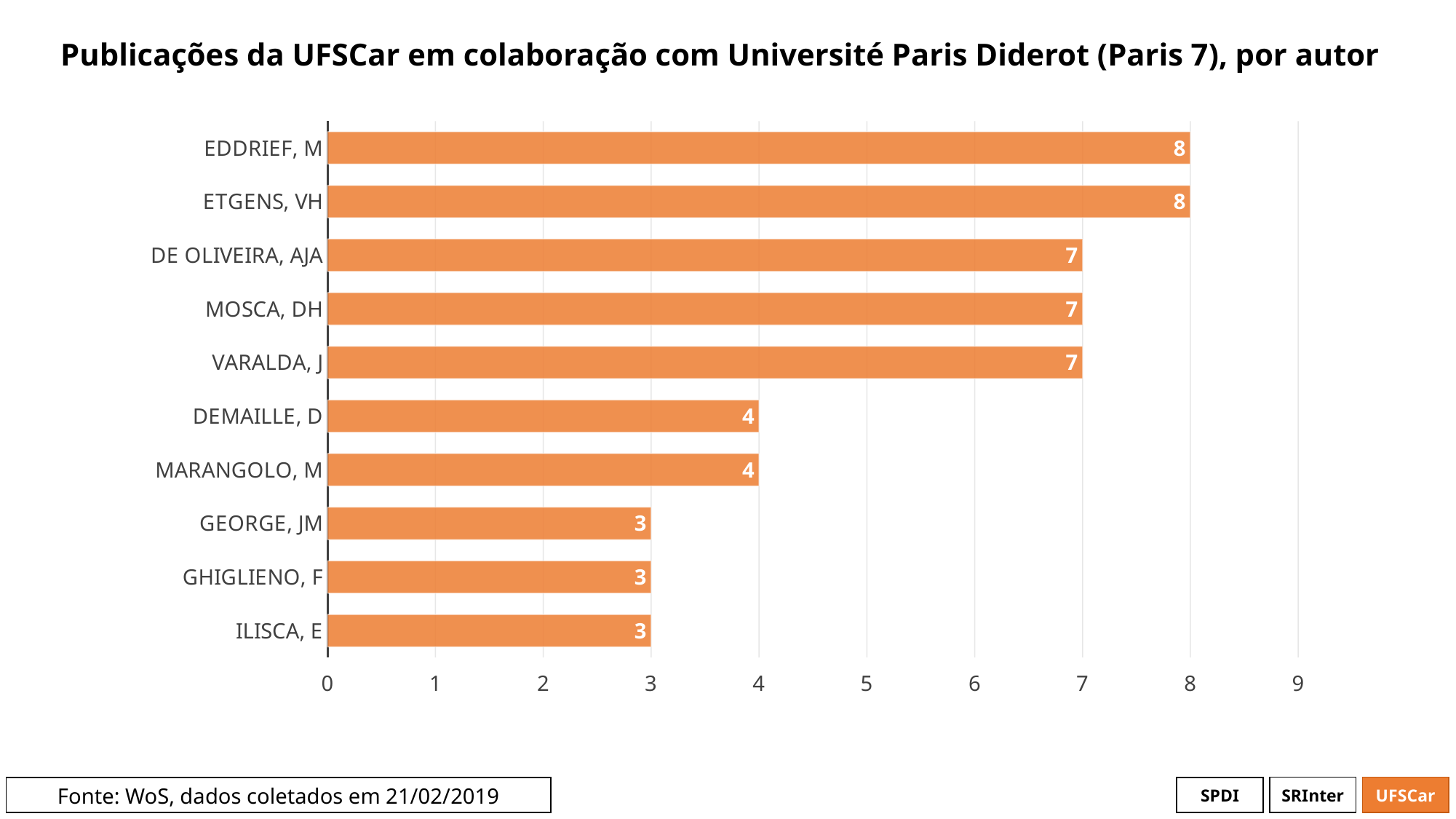
Which authors have the highest value? EDDRIEF, M and ETGENS, VH What is the title of the chart? Publicações da UFSCar em colaboração com Université Paris Diderot (Paris 7), por autor What is the value for ETGENS, VH? 8 What is the value for ILISCA, E? 3 What kind of chart is shown on the slide? bar chart What is the difference between the values for EDDRIEF, M and GEORGE, JM? 5 What is the value for DEMAILLE, D? 4 What is the lowest value shown on the chart? 3 What is the value for DE OLIVEIRA, AJA? 7 Is the value for VARALDA, J greater or less than 5? greater Which is larger, the value for MOSCA, DH or the value for MARANGOLO, M? MOSCA, DH How many authors are shown on the chart? 10